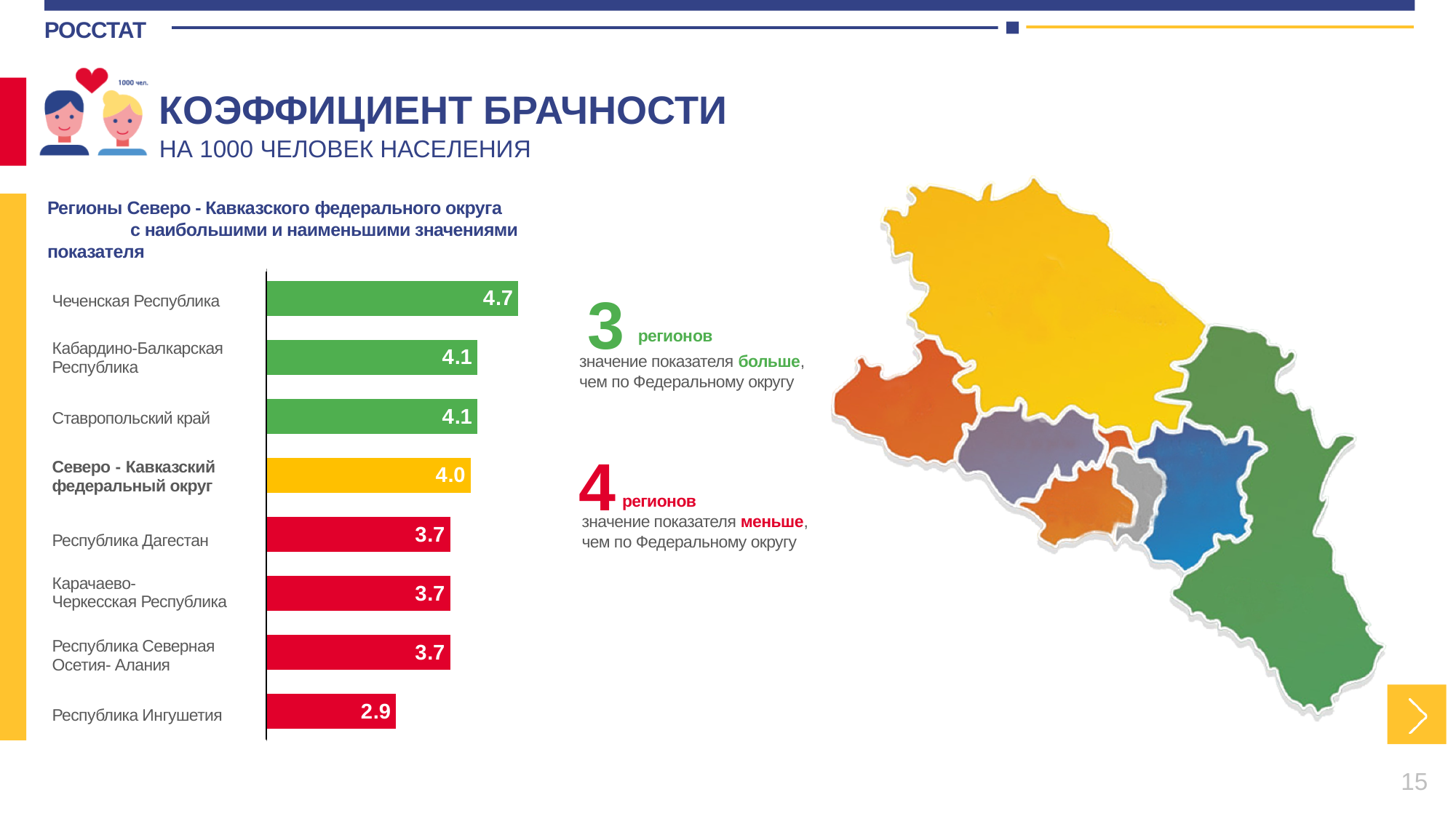
What value is shown for Республика Ингушетия? 2.9 What value is shown for Северо - Кавказский федеральный округ? 4.0 What is the marriage rate value shown for Чеченская Республика? 4.7 Which region has the highest value in the chart? Чеченская Республика Which is larger, the value for Республика Дагестан or the value for Чеченская Республика? Чеченская Республика What value is shown for Ставропольский край? 4.1 Which region has the lowest value in the chart? Республика Ингушетия What colour are the bars for regions with values below the federal district value? Red How many bars are shown in the chart? 8 What is the difference between the values for Кабардино-Балкарская Республика and Северо - Кавказский федеральный округ? 0.1 What is the difference between the values for Чеченская Республика and Республика Ингушетия? 1.8 What type of chart is used on the slide? Bar chart